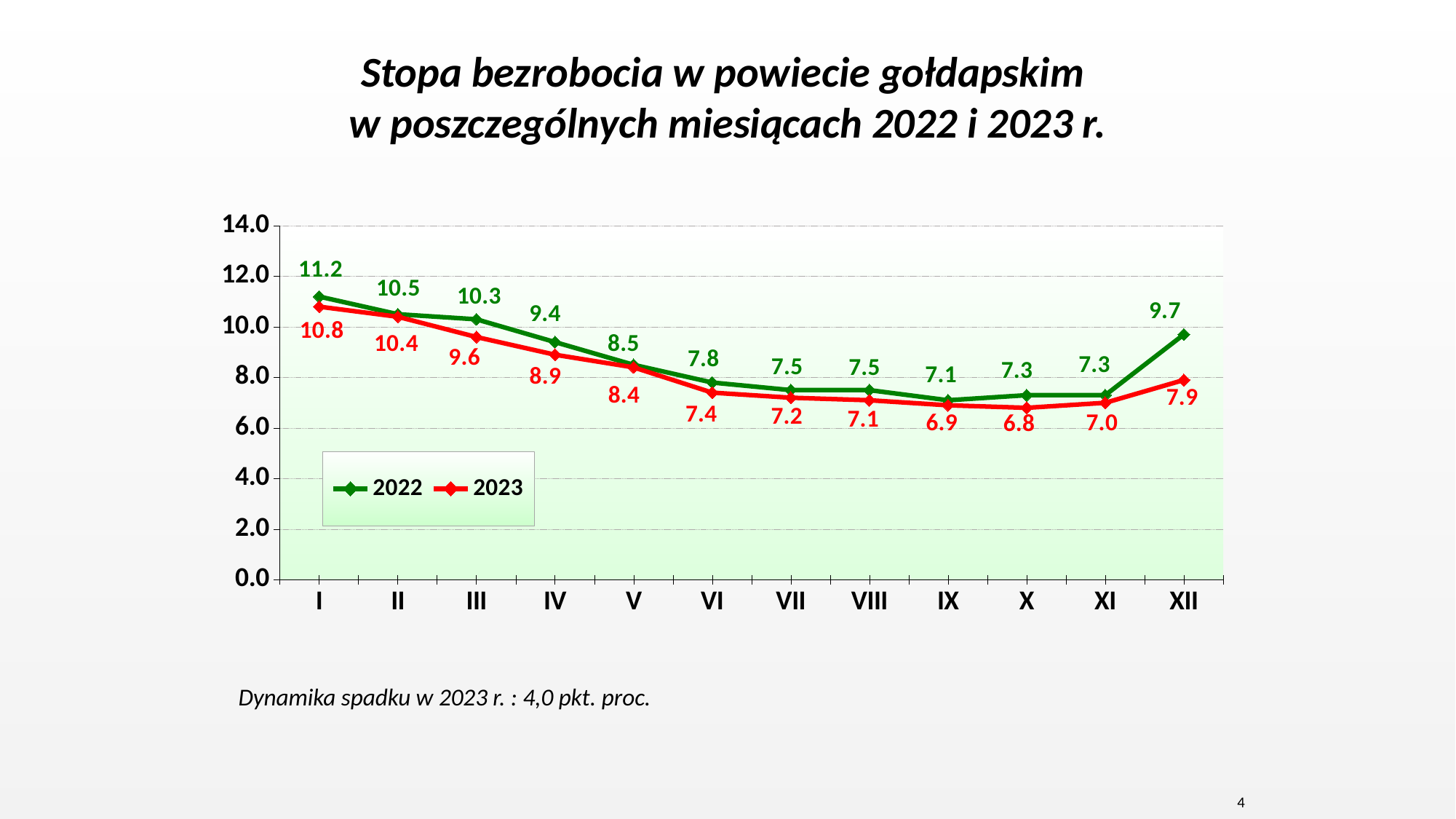
What is the difference between the 2022 values in month I and month XI? 3.9 What is the difference between the 2022 and 2023 values in month XII? 1.8 Which is larger, the 2022 value in month IV or the 2023 value in month IV? 2022 How many series does the legend list? 2 What is the value for 2023 in month X? 6.8 What is the value for 2023 in month XII? 7.9 What kind of chart is shown on the slide? line chart Which month has the lowest value for the 2023 series? X What is the value for 2022 in month I? 11.2 Which month has the highest value for the 2022 series? I Do the 2023 values rise or fall from month I to month X? fall How many months are shown on the x axis? 12